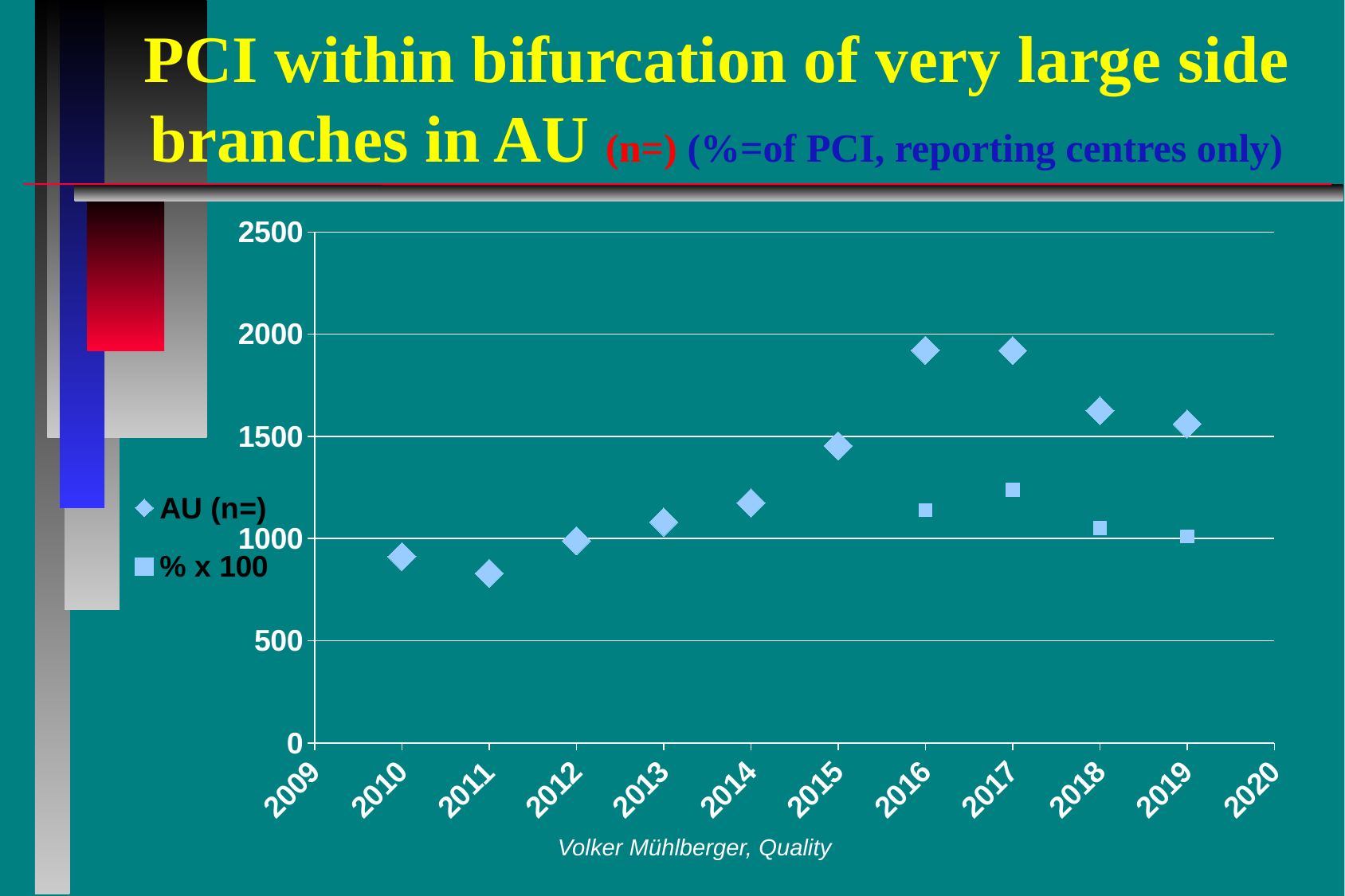
What are the two series named in the legend? AU (n=) and % x 100 What kind of chart is shown on the slide? scatter chart How many data points are plotted for the % x 100 series? 4 Is the AU (n=) value for 2011 greater or less than 1000? less Which is larger, the AU (n=) value for 2010 or for 2016? 2016 Is the % x 100 value for 2017 greater or less than 1000? greater In which year is the AU (n=) value lowest? 2011 How many series does the legend list? 2 Between 2011 and 2016, do the AU (n=) values rise or fall? rise Is the AU (n=) value for 2018 greater or less than 1500? greater How many data points are plotted for the AU (n=) series? 10